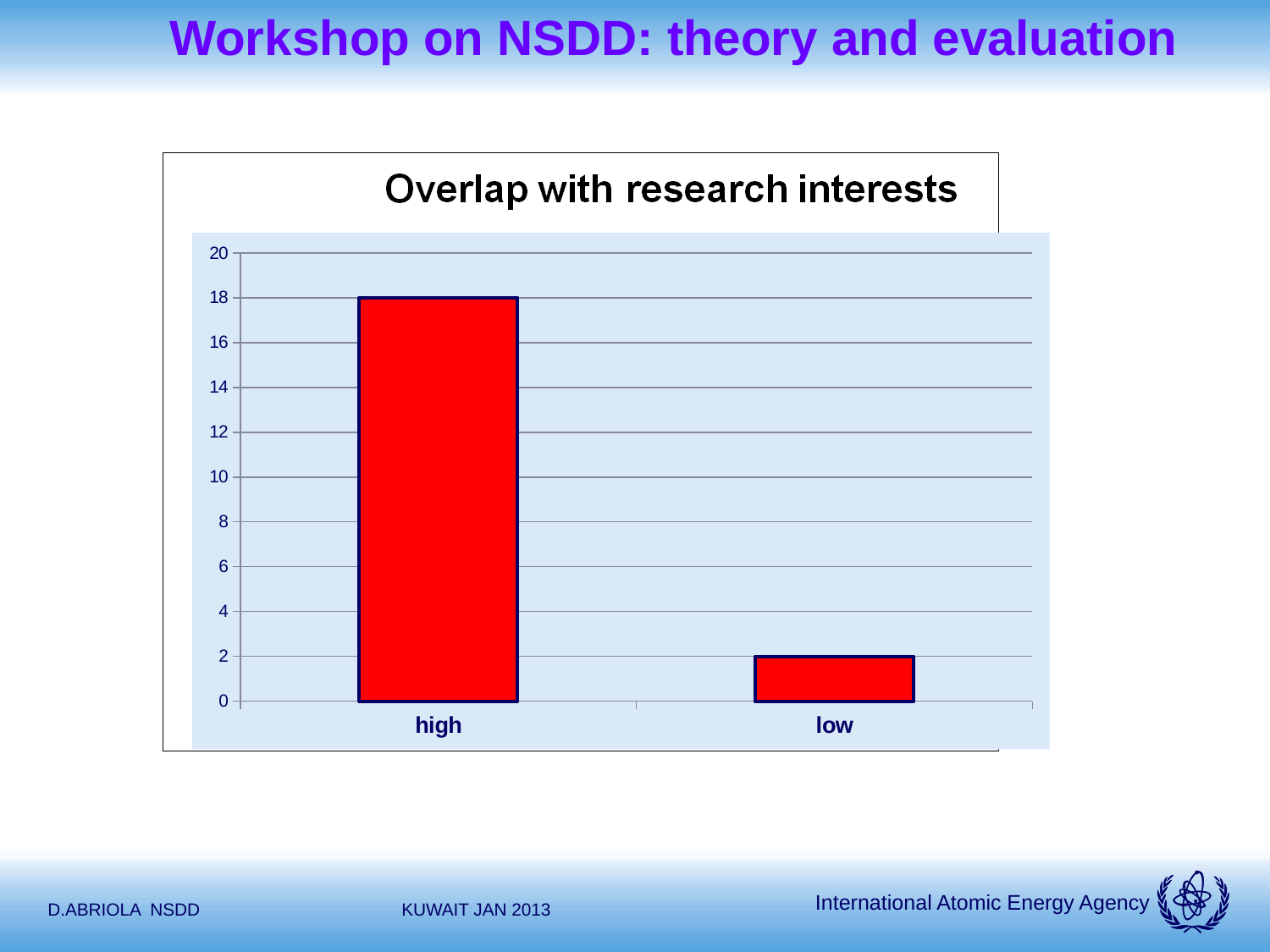
Which category has the lowest value? low What is the value for the 'low' category? 2 What kind of chart is shown on the slide? bar chart What is the value for the 'high' category? 18 What is the title of the chart? Overlap with research interests Which category has the highest value? high Is the value for 'high' greater or less than 10? greater What is the difference between the values for 'high' and 'low'? 16 Is the value for 'low' greater or less than 4? less What is the maximum value shown on the y axis of the chart? 20 Which is larger, the value for 'high' or the value for 'low'? high How many categories are shown on the x axis of the chart? 2